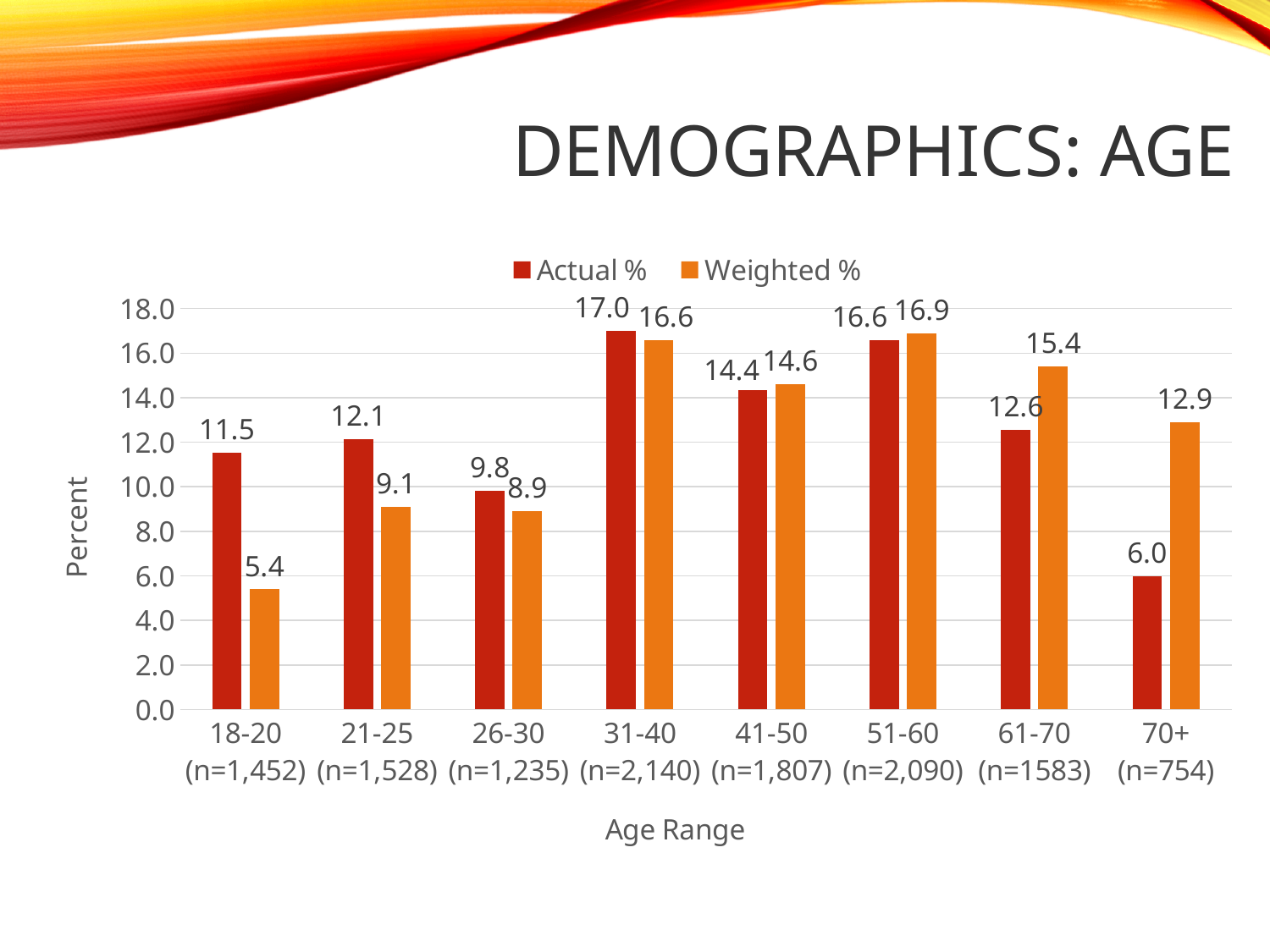
Which age range has the lowest Weighted % value? 18-20 What is the sample size (n) shown for the 31-40 age range? n=2,140 What is the Actual % value for the 18-20 age range? 11.5 Which is larger for the 70+ age range, the Actual % or the Weighted %? Weighted % What is the Weighted % value for the 70+ age range? 12.9 What is the Weighted % value for the 61-70 age range? 15.4 What is the label of the y axis? Percent What is the difference between the Actual % and Weighted % values for the 18-20 age range? 6.1 How many age ranges are shown on the x axis? 8 Which age range has the highest Actual % value? 31-40 What kind of chart is shown on the slide? Bar chart How many series does the legend list? 2